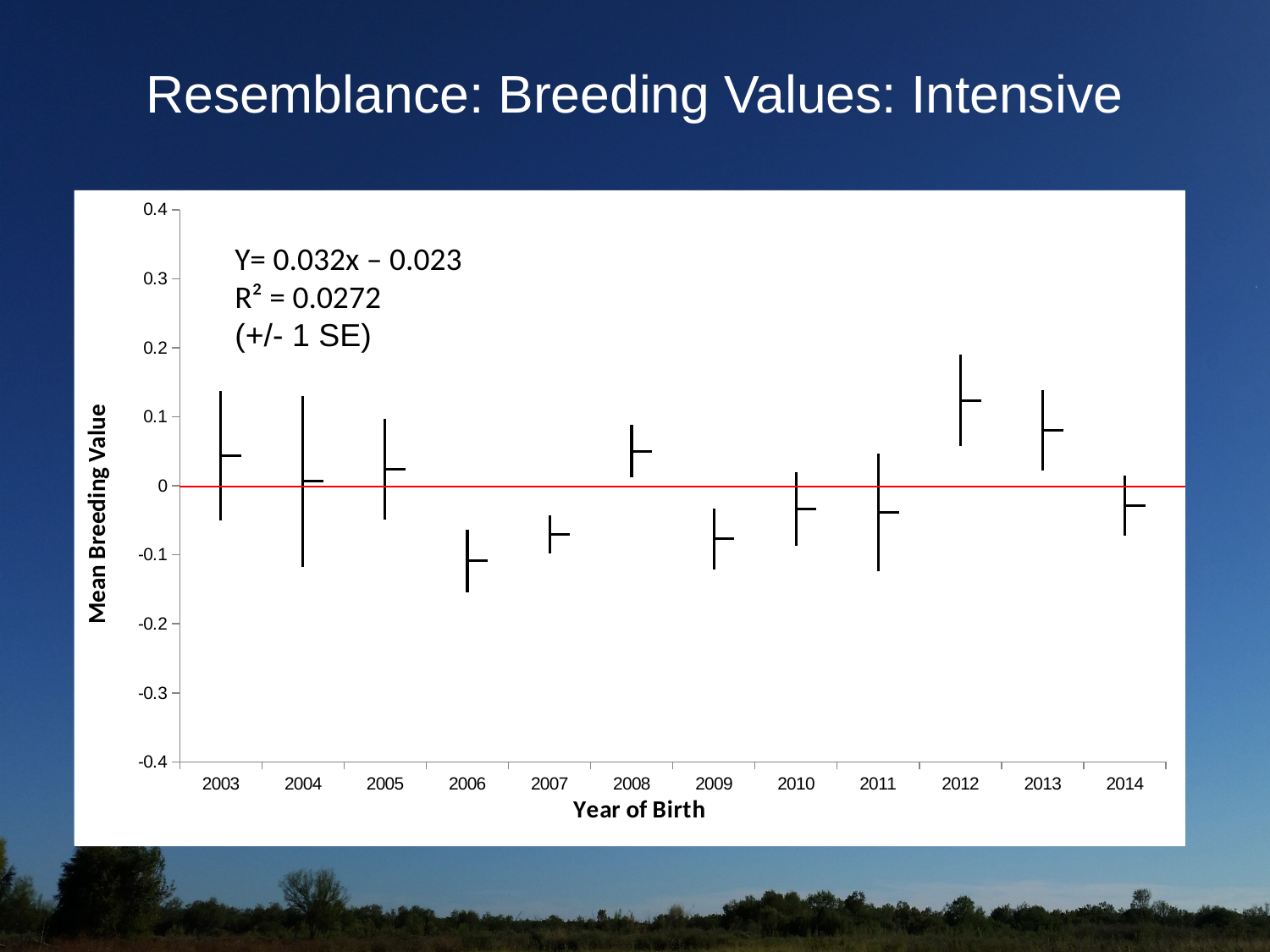
Which year of birth has the lowest mean breeding value? 2006 Is the mean breeding value for 2006 greater or less than 0? less What is the R² value shown on the chart? 0.0272 Which has the larger mean breeding value, 2008 or 2007? 2008 Is the mean breeding value for 2009 greater or less than 0? less Is the mean breeding value for 2008 greater or less than 0.1? less How many years of birth are plotted on the chart? 12 Which year of birth has the highest mean breeding value? 2012 Which has the larger mean breeding value, 2013 or 2014? 2013 What is the title of the y axis? Mean Breeding Value